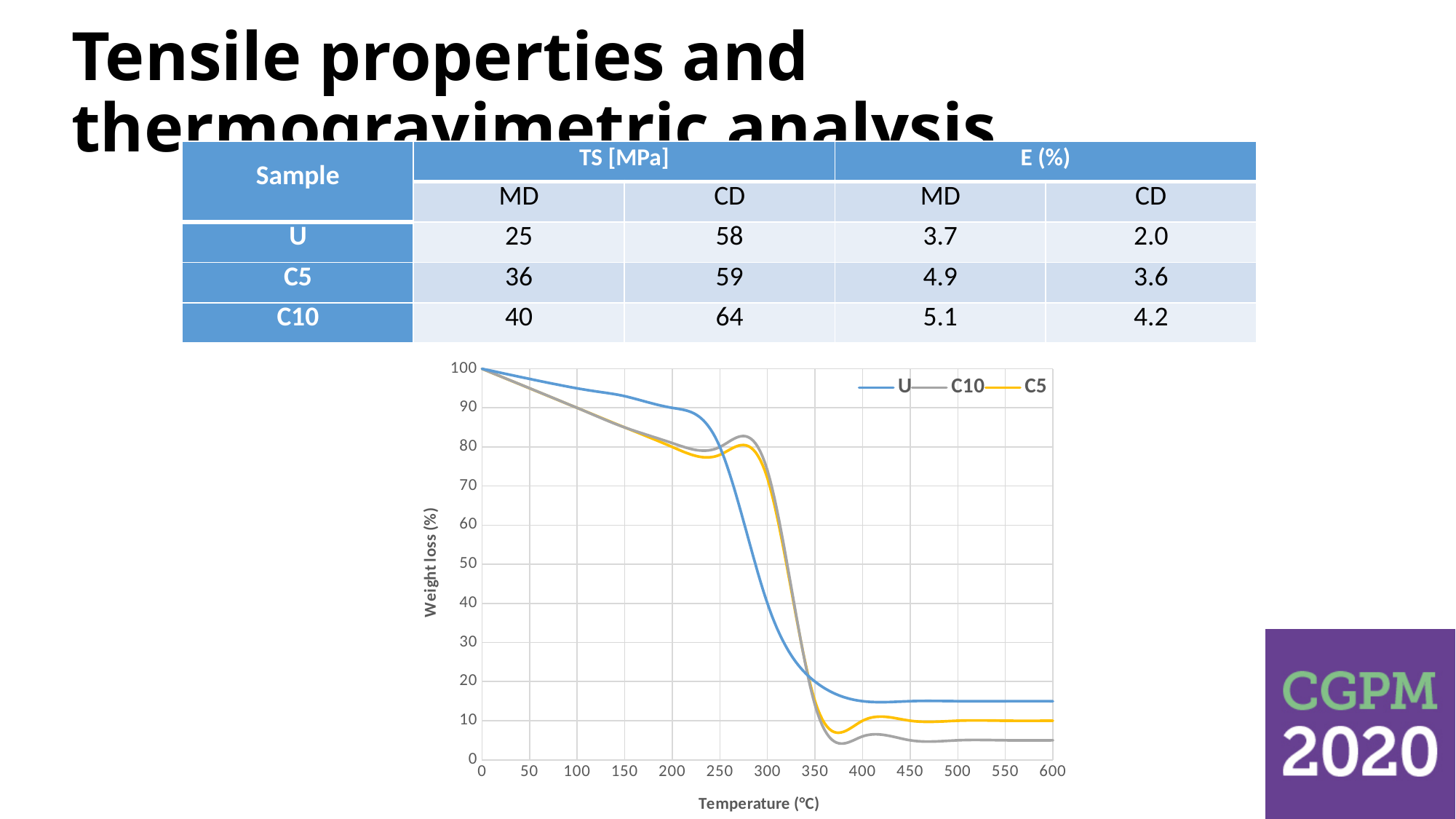
Is the value for U at 600 °C greater or less than 10? greater At 300 °C, which series has the higher value, C5 or U? C5 Which series are listed in the chart legend? U, C10, C5 Is the value for U at 100 °C greater or less than 90? greater What kind of chart is shown on the slide? line chart At 600 °C, which series has the higher value, U or C10? U What is the weight loss value for U at 0 °C? 100 Is the value for C10 at 600 °C greater or less than 10? less What is the title of the chart's x axis? Temperature (°C) How many series does the chart legend list? 3 Do the weight loss values rise or fall as temperature increases along the x axis? fall